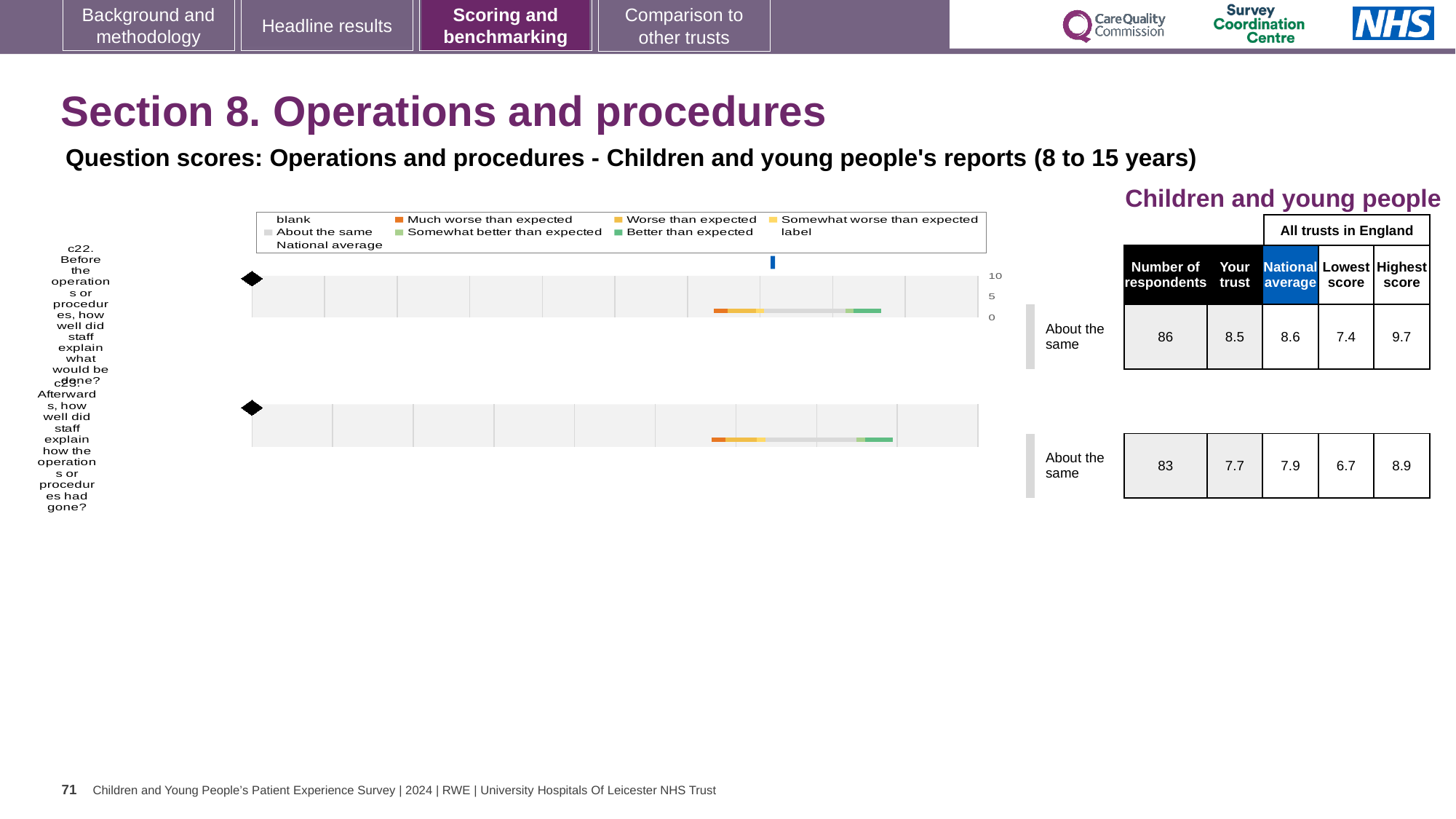
How many survey questions are plotted on this slide? 2 For question c22 (Before the operations or procedures, how well did staff explain what would be done?), what is the 'Your trust' score? 8.5 What colour does the legend use for 'Much worse than expected'? Orange What benchmark category is shown for question c22? About the same What is the Highest score among all trusts in England for question c23? 8.9 For question c23, how much higher is the National average than the 'Your trust' score? 0.2 What is the Lowest score among all trusts in England for question c22? 7.4 What kind of chart is used to show the question scores on this slide? Bar chart Which question has the higher 'Your trust' score, c22 or c23? c22 What is the difference between the Highest score and the Lowest score for question c22? 2.3 How many respondents are shown for question c23 (Afterwards, how well did staff explain how the operations or procedures had gone?)? 83 For question c22, what is the National average score? 8.6